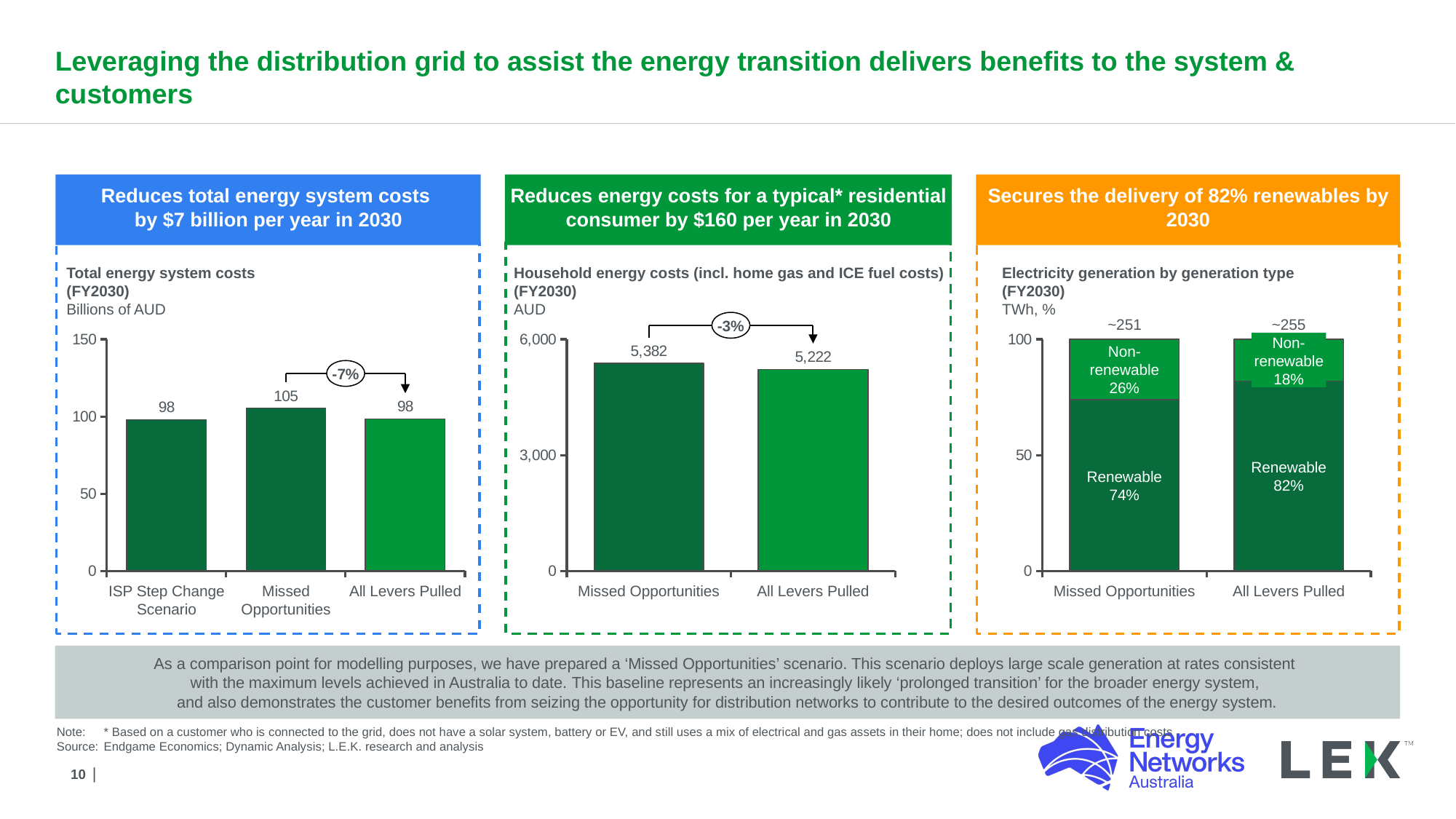
What type of chart is the 'Household energy costs (incl. home gas and ICE fuel costs) (FY2030)' chart? bar chart How many bars are in the 'Total energy system costs (FY2030)' chart? 3 In the 'Total energy system costs (FY2030)' chart, which scenario has the highest value? Missed Opportunities In the 'Total energy system costs (FY2030)' chart, what is the value for Missed Opportunities? 105 In the 'Household energy costs (incl. home gas and ICE fuel costs) (FY2030)' chart, what is the value for All Levers Pulled? 5,222 In the 'Household energy costs (incl. home gas and ICE fuel costs) (FY2030)' chart, what is the difference between Missed Opportunities and All Levers Pulled? 160 In the 'Electricity generation by generation type (FY2030)' chart, what is the Renewable share for All Levers Pulled? 82% In the 'Total energy system costs (FY2030)' chart, is the value for ISP Step Change Scenario greater or less than 100? less In the 'Household energy costs (incl. home gas and ICE fuel costs) (FY2030)' chart, which is larger, Missed Opportunities or All Levers Pulled? Missed Opportunities In the 'Electricity generation by generation type (FY2030)' chart, what is the Non-renewable share for Missed Opportunities? 26% In the 'Total energy system costs (FY2030)' chart, what is the difference between Missed Opportunities and All Levers Pulled? 7 What unit is shown under the title of the 'Total energy system costs (FY2030)' chart? Billions of AUD